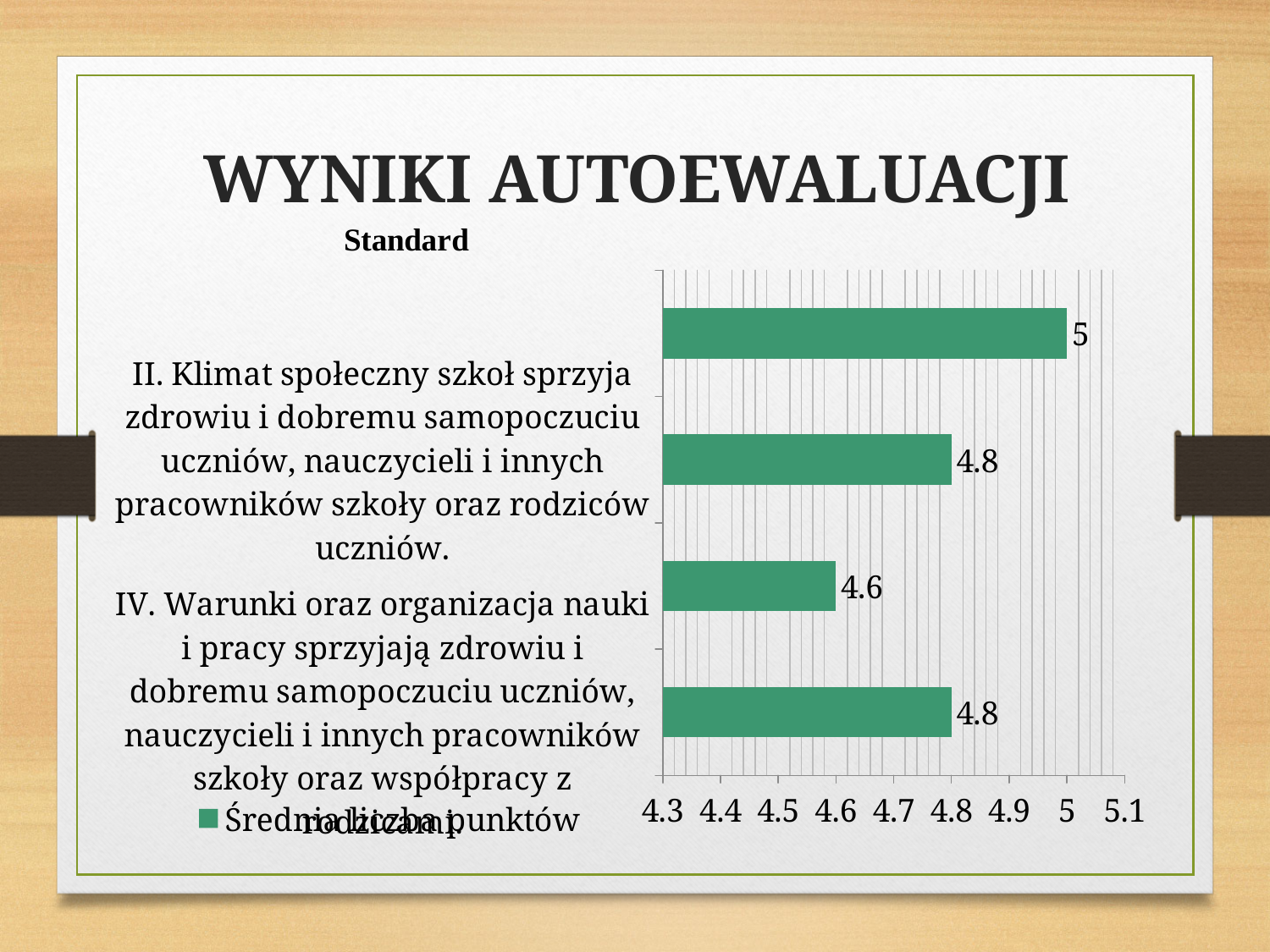
What is the value of the top bar in the chart? 5 What is the legend entry of the chart? Średnia liczba punktów What is the value of the third bar from the top? 4.6 What kind of chart is shown on the slide? bar chart How many series does the chart legend list? 1 What is the difference between the top bar's value and the third bar's value? 0.4 What is the value of the bottom bar in the chart? 4.8 Which bar has the highest value? the top bar Which bar has the lowest value? the third bar from the top How many bars does the chart contain? 4 Which is larger, the second bar from the top or the third bar from the top? the second bar from the top